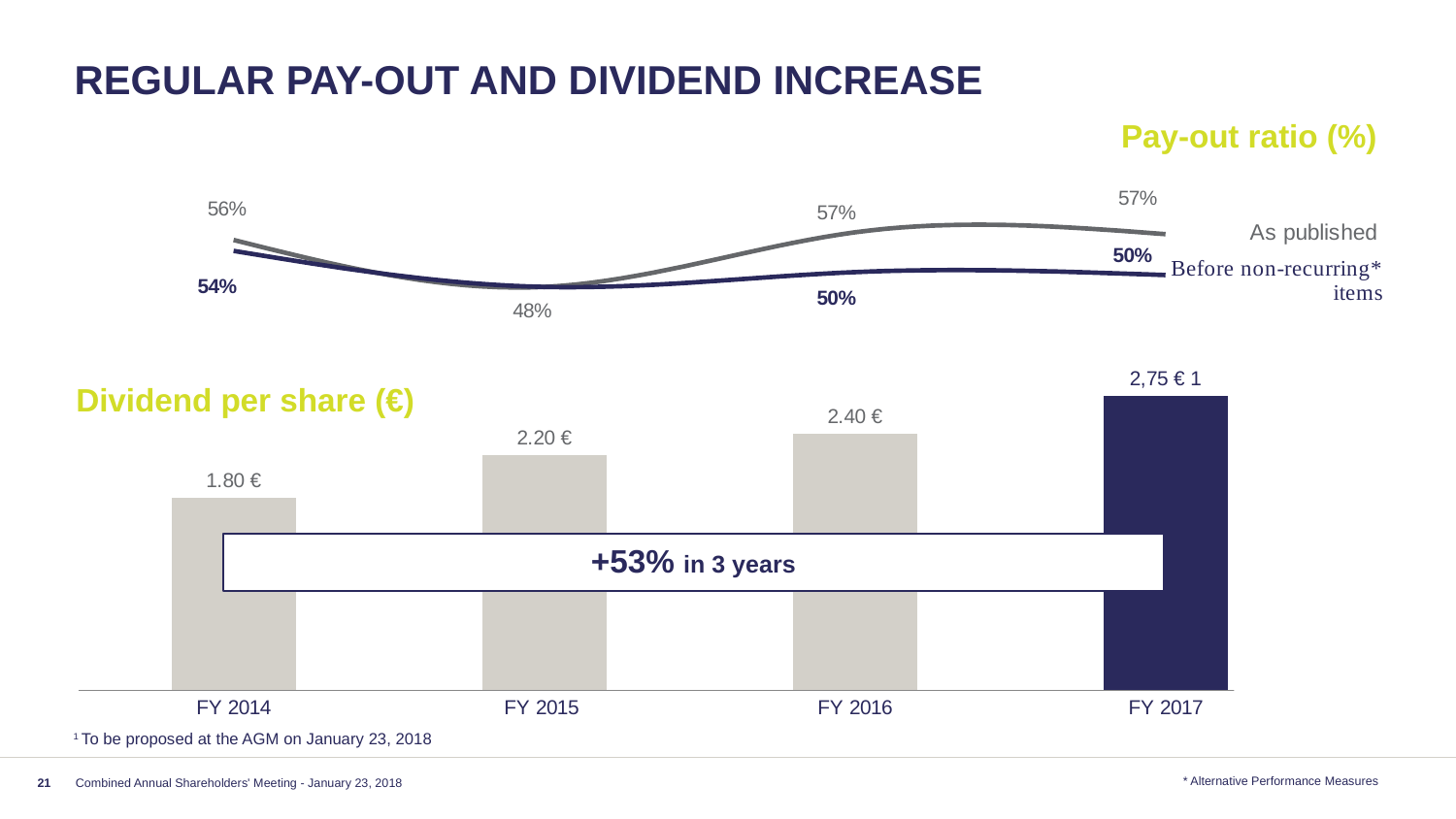
In the Dividend per share (€) chart, what is the difference between the FY 2016 and FY 2015 dividend per share? 0.20 € In the Pay-out ratio (%) chart, what is the lowest value labelled on the As published line? 48% In the Dividend per share (€) chart, which fiscal year has the highest dividend per share? FY 2017 What kind of chart is the Dividend per share (€) chart? bar chart How many series does the Pay-out ratio (%) chart show? 2 How many fiscal years are shown in the Dividend per share (€) chart? 4 In the Dividend per share (€) chart, which fiscal year has the lowest dividend per share? FY 2014 In the Dividend per share (€) chart, what is the dividend per share for FY 2017? 2,75 € In the Dividend per share (€) chart, what is the dividend per share for FY 2016? 2.40 € In the Pay-out ratio (%) chart, at the rightmost point, which series is higher: As published or Before non-recurring items? As published In the Dividend per share (€) chart, what is the dividend per share for FY 2014? 1.80 € In the Dividend per share (€) chart, do the values rise or fall from FY 2014 to FY 2017? rise